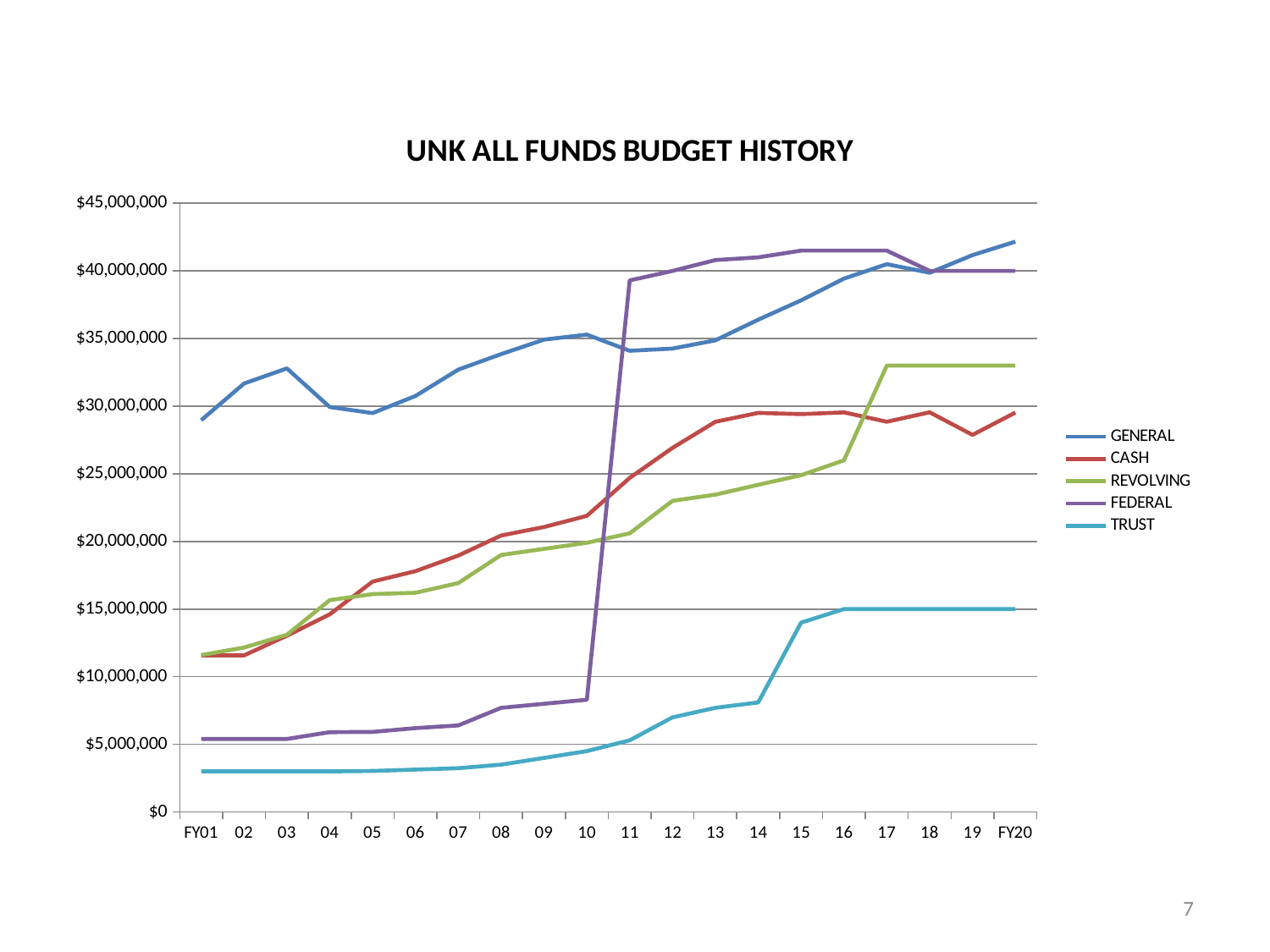
Which series has the lowest value in FY20? TRUST In FY20, which is larger, GENERAL or FEDERAL? GENERAL How many fiscal years are plotted along the x axis? 20 Is the value for FEDERAL in FY10 greater or less than $10,000,000? less Does the TRUST series rise or fall from FY01 to FY20? rise Is the value for REVOLVING in FY20 greater or less than $30,000,000? greater What kind of chart is shown on the slide? line chart What is the title of the chart? UNK ALL FUNDS BUDGET HISTORY How many series does the legend list? 5 Is the value for GENERAL in FY03 greater or less than $30,000,000? greater Which series has the highest value in FY01? GENERAL